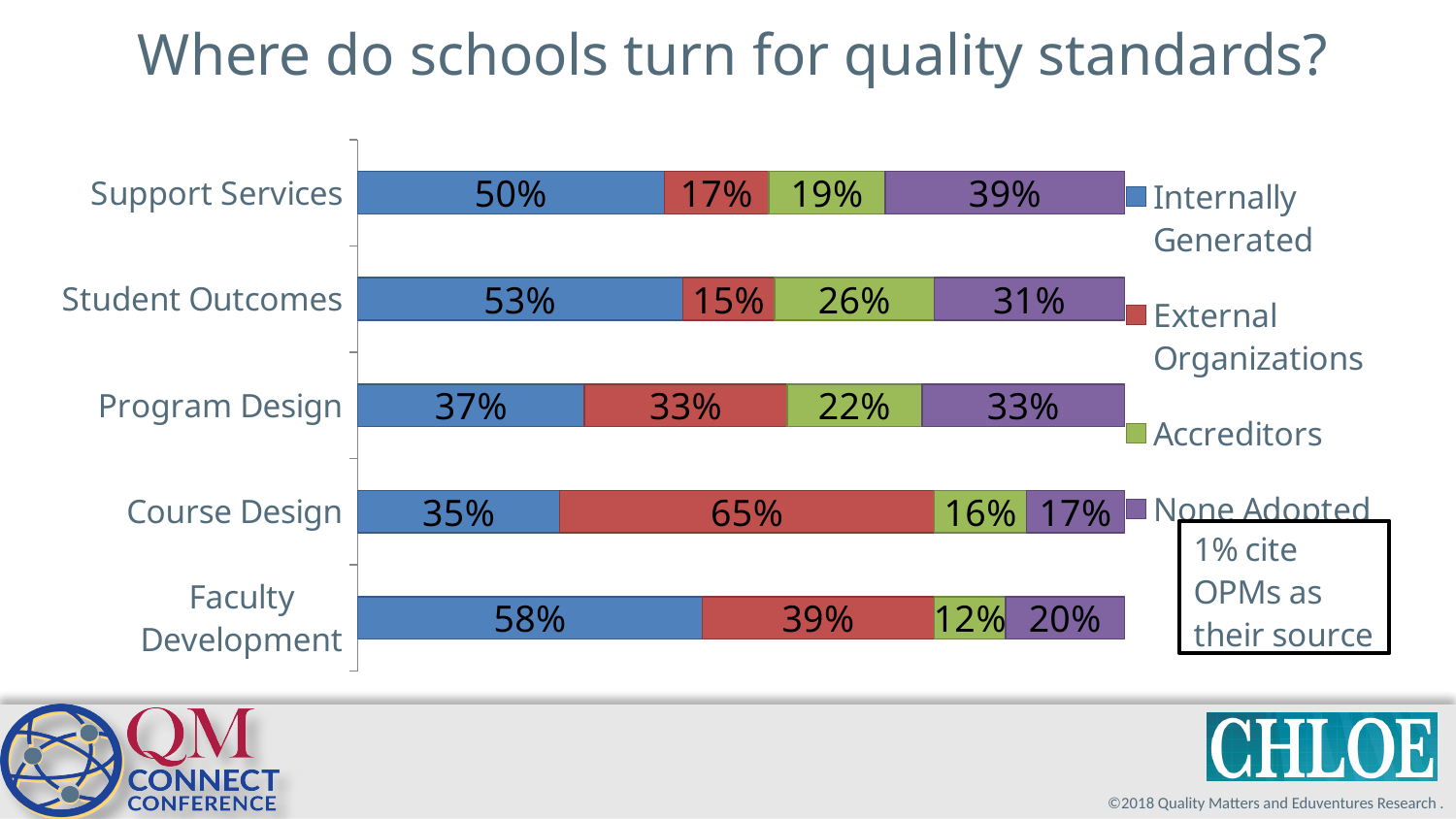
What is the None Adopted value for Faculty Development? 20% What is the External Organizations value for Course Design? 65% How many categories are shown on the chart? 5 What type of chart is shown on the slide? Stacked bar chart Which category has the lowest Accreditors value? Faculty Development Which category has the highest Internally Generated value? Faculty Development Which is larger for Program Design: the Internally Generated value or the External Organizations value? Internally Generated What is the difference between the External Organizations values for Course Design and Program Design? 32% What is the Accreditors value for Student Outcomes? 26% Which category has the highest None Adopted value? Support Services How many series does the legend list? 4 What percentage of schools cite Internally Generated standards for Support Services? 50%